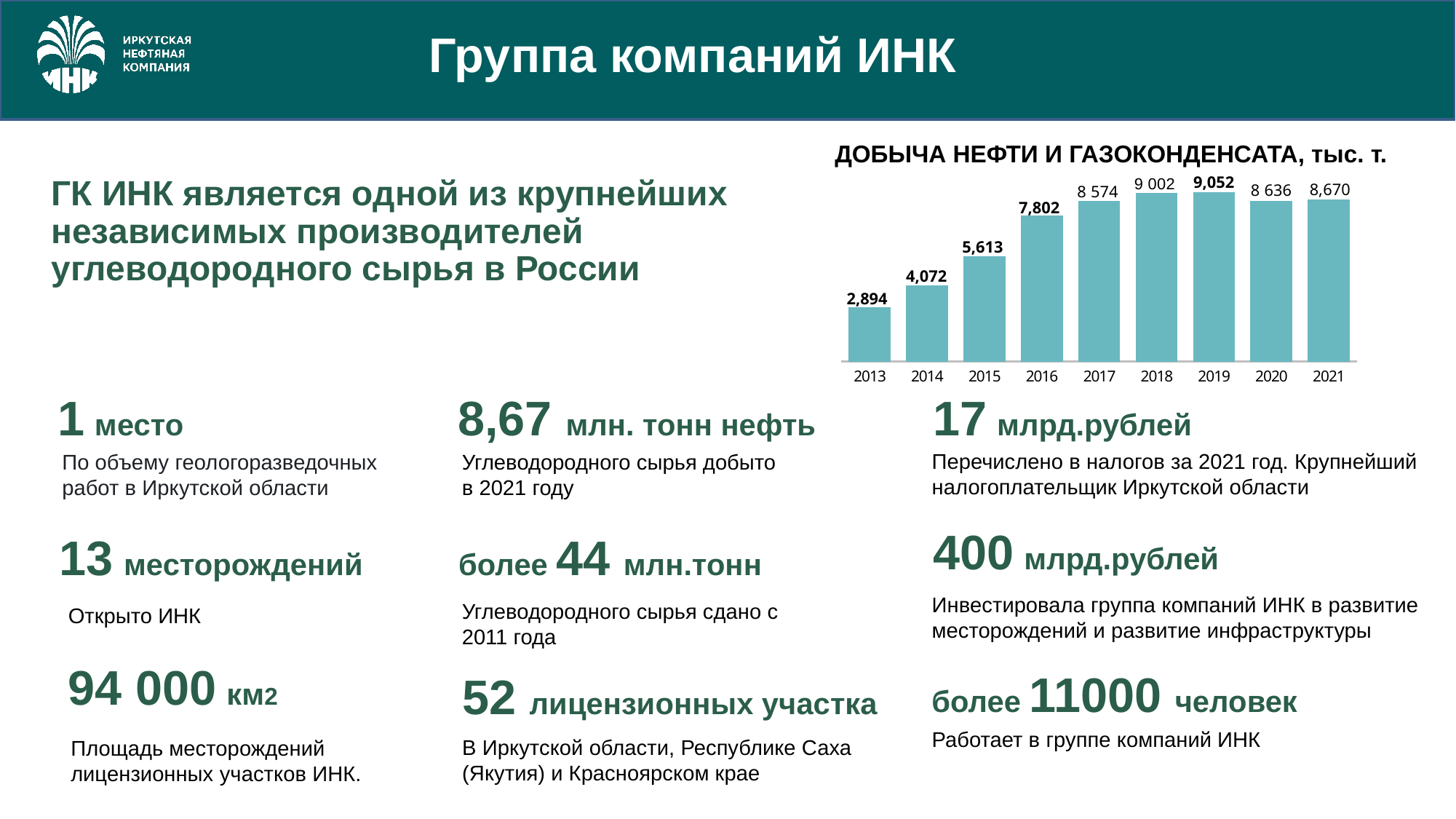
What is the value for 2018 in the chart? 9 002 Which year has the highest value in the chart? 2019 What is the title of the chart? ДОБЫЧА НЕФТИ И ГАЗОКОНДЕНСАТА, тыс. т. What is the difference between the values for 2019 and 2013? 6,158 What is the difference between the values for 2021 and 2020? 34 Which year has the lowest value in the chart? 2013 What is the value for 2016 in the chart? 7,802 Which is larger, the value for 2015 or the value for 2017? 2017 What is the value for 2021 in the chart? 8,670 What is the value for 2013 in the chart? 2,894 How many years are shown on the x axis of the chart? 9 What kind of chart is shown on the slide? Bar chart